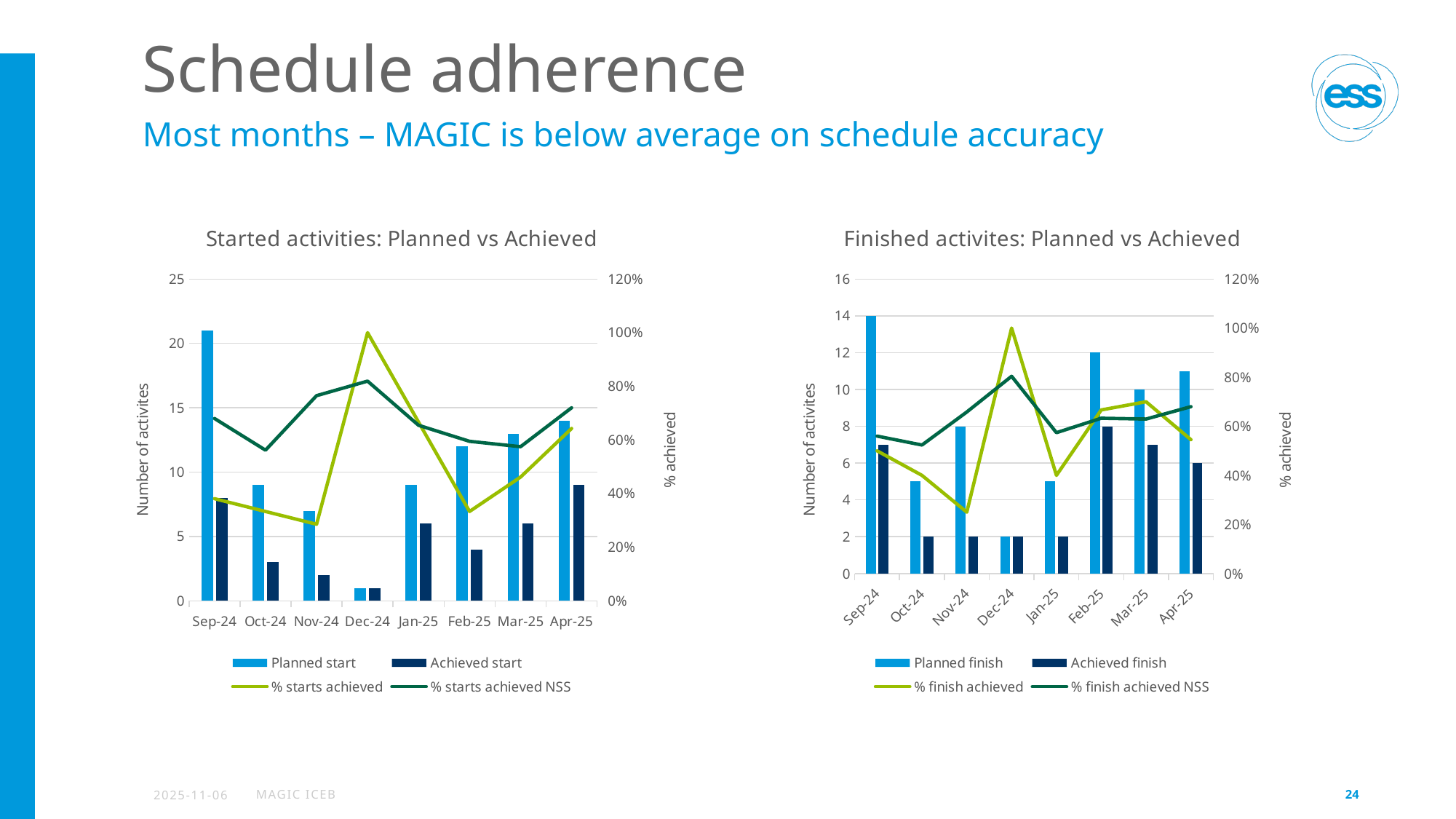
In the 'Started activities: Planned vs Achieved' chart, which is larger: the Planned start for Sep-24 or the Planned start for Apr-25? Sep-24 How many months are shown on the x axis of the 'Started activities: Planned vs Achieved' chart? 8 What is the label of the right-hand vertical axis in the 'Started activities: Planned vs Achieved' chart? % achieved In the 'Started activities: Planned vs Achieved' chart, which month has the highest Planned start value? Sep-24 In the 'Finished activites: Planned vs Achieved' chart, what is the Achieved finish value for Oct-24? 2 In the 'Finished activites: Planned vs Achieved' chart, what is the Planned finish value for Feb-25? 12 In the 'Finished activites: Planned vs Achieved' chart, what is the Planned finish value for Sep-24? 14 In the 'Finished activites: Planned vs Achieved' chart, what is the difference between Planned finish and Achieved finish for Feb-25? 4 In the 'Started activities: Planned vs Achieved' chart, is the Planned start value for Sep-24 greater or less than 20? greater How many series does the legend of the 'Finished activites: Planned vs Achieved' chart list? 4 In the 'Finished activites: Planned vs Achieved' chart, which month has the lowest Planned finish value? Dec-24 In the 'Finished activites: Planned vs Achieved' chart, what is the Achieved finish value for Feb-25? 8